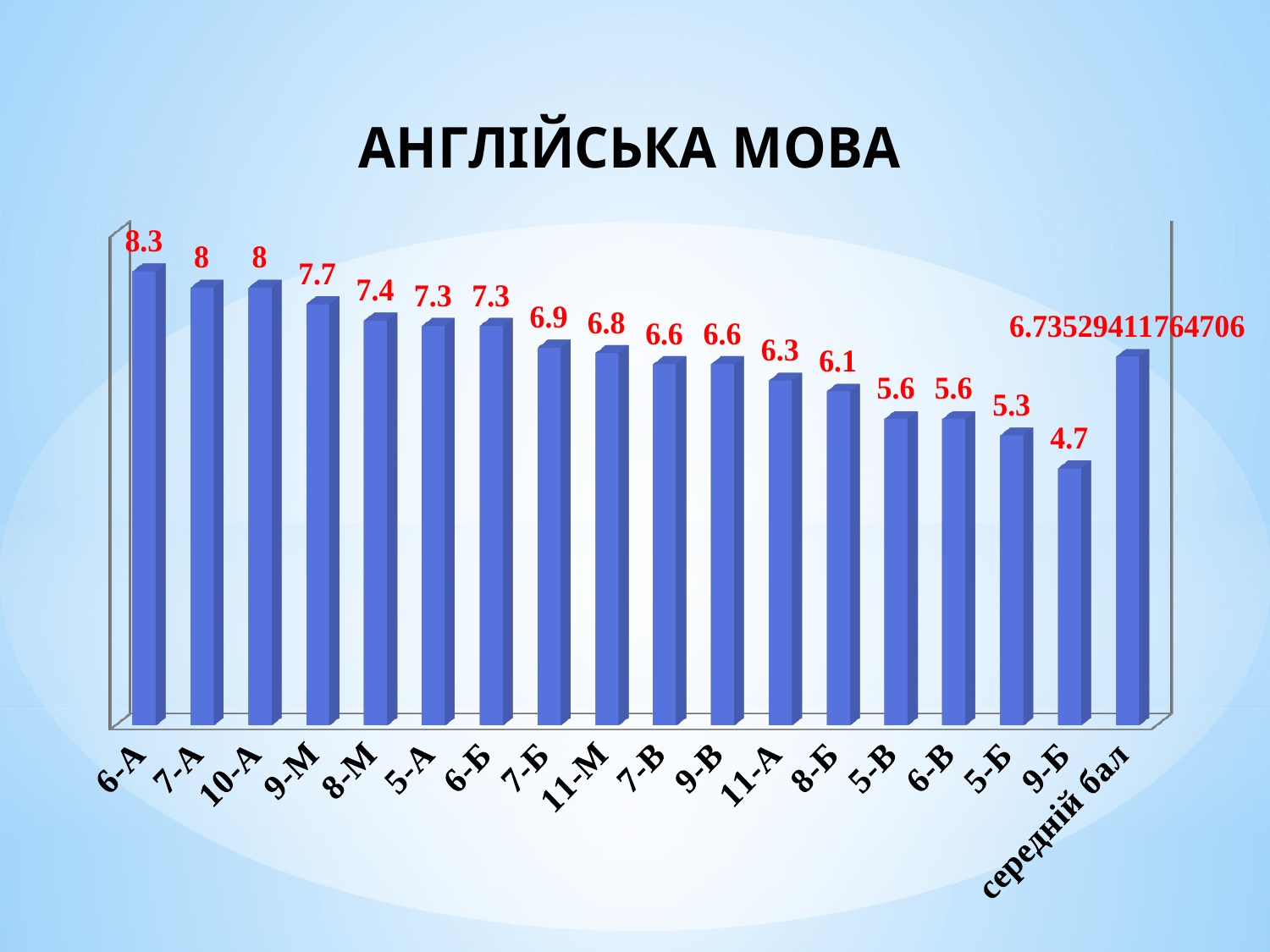
What is the value for 9-М? 7.7 Which is larger, the value for 7-Б or the value for 11-А? 7-Б What is the title of the chart? АНГЛІЙСЬКА МОВА What kind of chart is shown on the slide? Bar chart How many bars are plotted in the chart? 18 What is the value shown for середній бал? 6.73529411764706 Which class has the highest value? 6-А What is the difference between the values for 6-А and 9-Б? 3.6 What is the value for 6-А? 8.3 Which class has the lowest value? 9-Б What is the difference between the values for 8-М and 8-Б? 1.3 What is the value for 11-М? 6.8